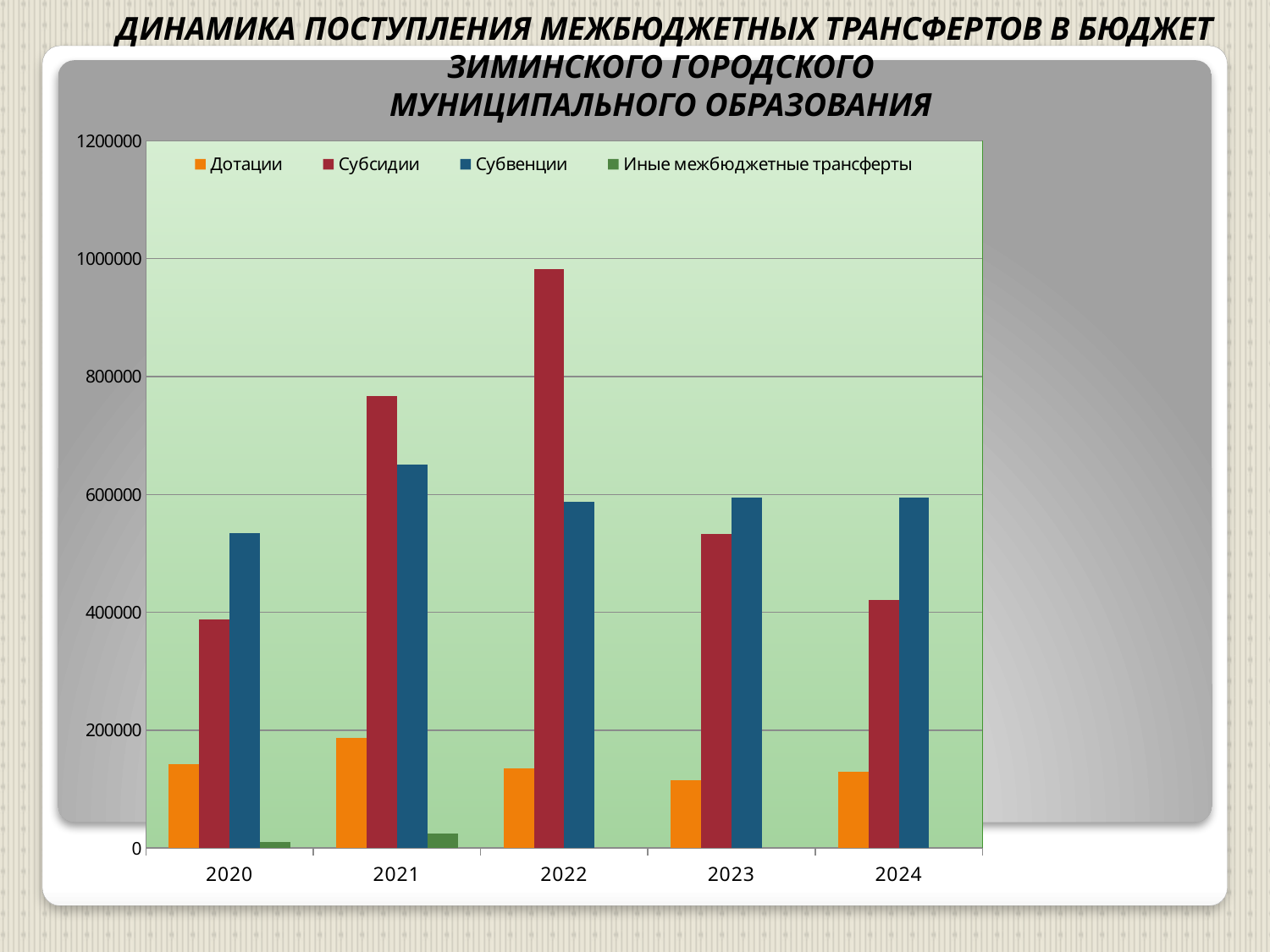
Is the value for Дотации in 2021 greater or less than 200000? less In which year is the value for Субсидии highest? 2022 In 2021, which is larger: Субсидии or Субвенции? Субсидии Do the values for Субсидии rise or fall from 2022 to 2024? fall Is the value for Субвенции in 2020 greater or less than 600000? less How many years are shown on the x axis? 5 In which year is the value for Дотации highest? 2021 How many series does the legend list? 4 In which year is the value for Субсидии lowest? 2020 In 2024, which is larger: Субвенции or Субсидии? Субвенции Is the value for Субсидии in 2022 greater or less than 800000? greater What kind of chart is shown on the slide? bar chart